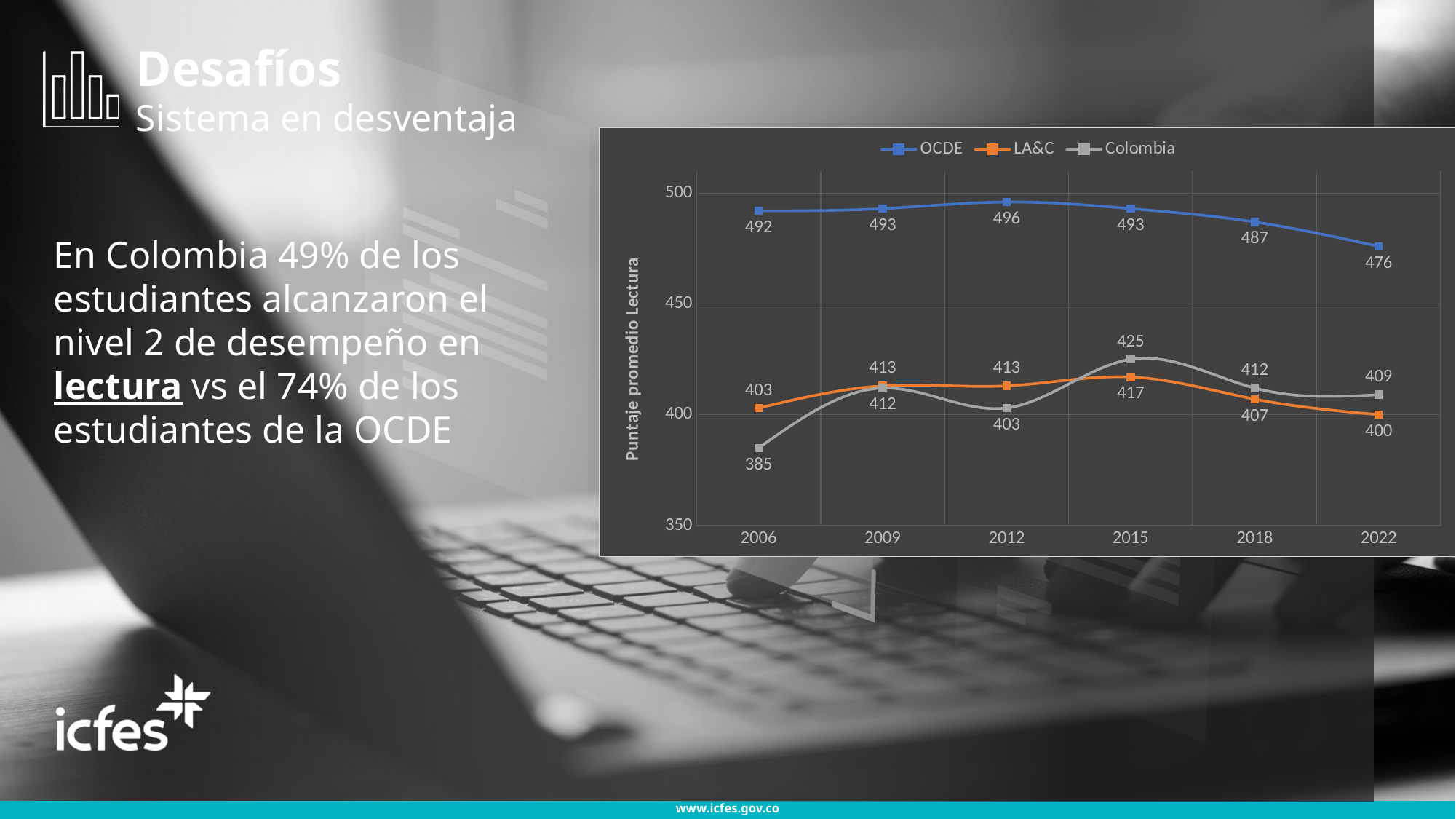
What was the LA&C average reading score in 2022? 400 What was the OCDE average reading score in 2012? 496 What kind of chart is shown on the slide? Line chart What is the difference between the OCDE and Colombia average reading scores in 2022? 67 What was Colombia's average reading score in 2006? 385 In which year was the OCDE average reading score lowest? 2022 How many series does the legend list? 3 What is the label of the vertical axis? Puntaje promedio Lectura Which had a higher average reading score in 2015, LA&C or Colombia? Colombia In which year did Colombia reach its highest average reading score? 2015 Does the OCDE average reading score rise or fall between 2015 and 2022? Fall How many years are shown on the x axis? 6